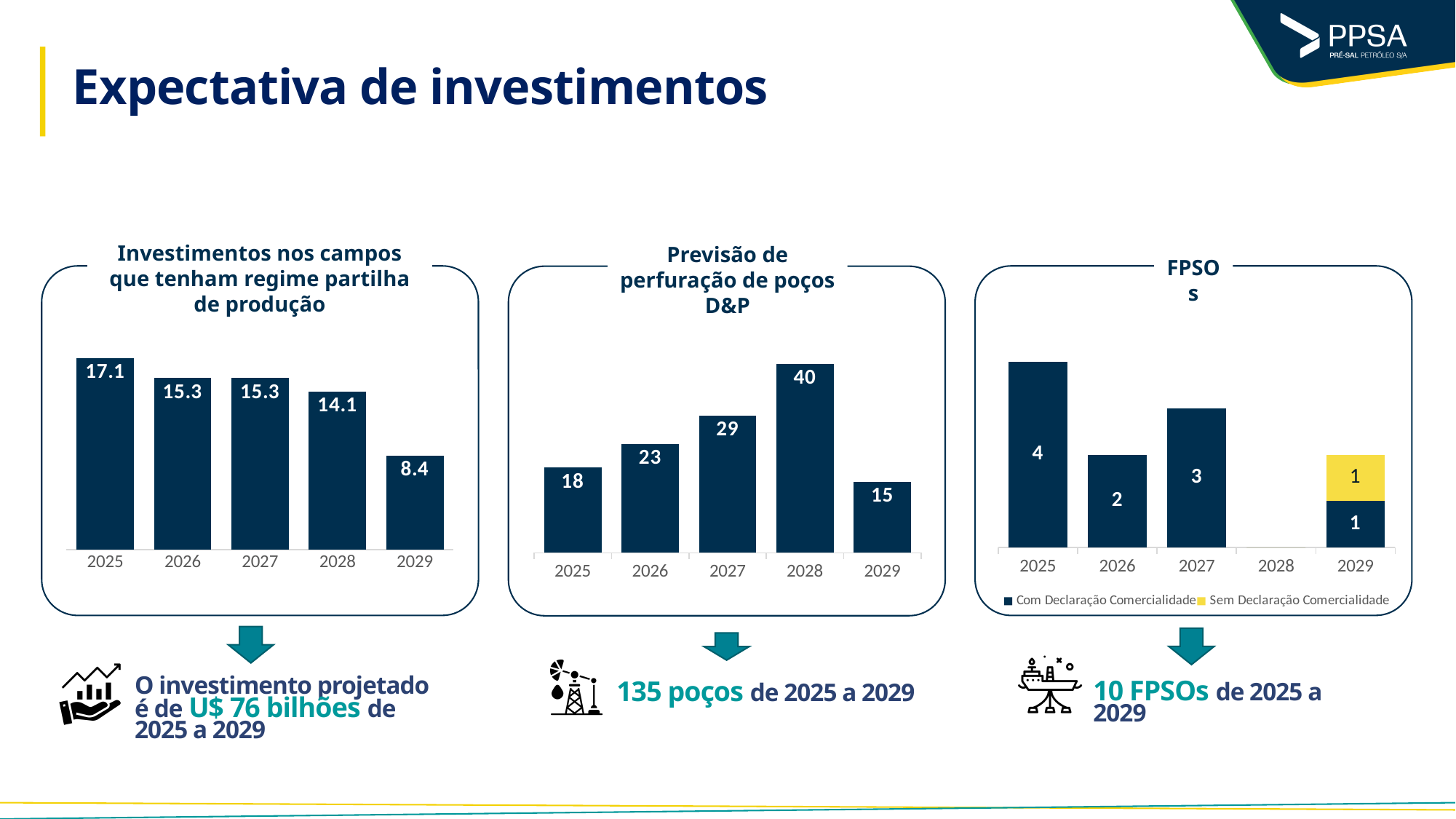
In the chart 'Investimentos nos campos que tenham regime partilha de produção', which year has the lowest value? 2029 In the 'FPSOs' chart, how many series does the legend list? 2 In the chart 'Investimentos nos campos que tenham regime partilha de produção', do the values generally rise or fall from 2025 to 2029? fall In the chart 'Previsão de perfuração de poços D&P', how many years are shown on the x axis? 5 In the 'FPSOs' chart, what is the total of the stacked bar for 2029? 2 In the chart 'Investimentos nos campos que tenham regime partilha de produção', what is the difference between the values for 2025 and 2029? 8.7 In the chart 'Previsão de perfuração de poços D&P', which year has the highest value? 2028 What kind of chart is the 'FPSOs' chart? stacked bar chart In the chart 'Previsão de perfuração de poços D&P', which is larger, the value for 2026 or the value for 2029? 2026 In the chart 'Previsão de perfuração de poços D&P', what is the difference between the values for 2028 and 2029? 25 In the chart 'Investimentos nos campos que tenham regime partilha de produção', what is the value for 2025? 17.1 In the chart 'Previsão de perfuração de poços D&P', what is the value for 2027? 29